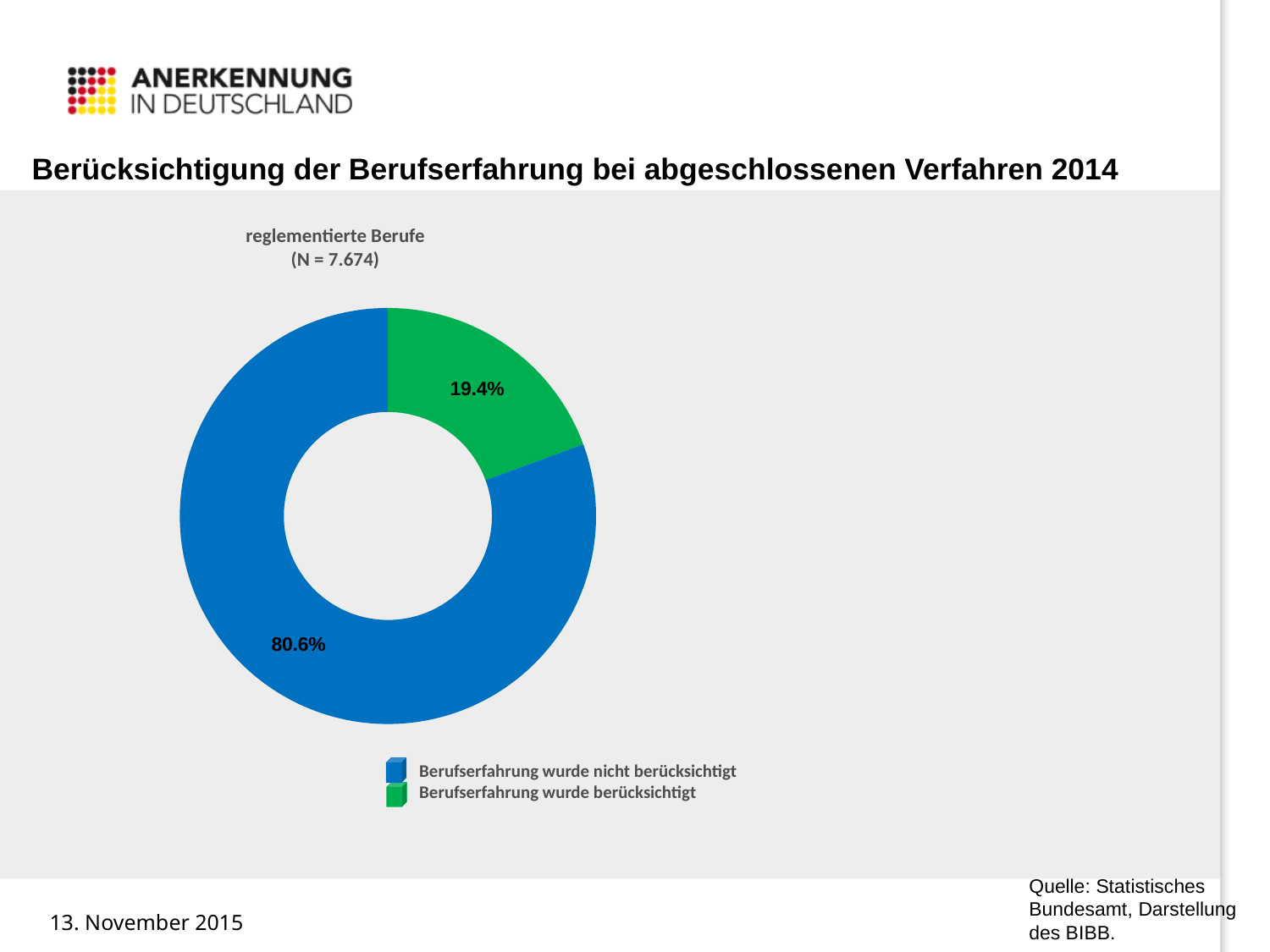
Which slice is larger: 'Berufserfahrung wurde berücksichtigt' or 'Berufserfahrung wurde nicht berücksichtigt'? Berufserfahrung wurde nicht berücksichtigt What is the difference in percentage points between the two slices of the chart? 61.2 Which colour represents 'Berufserfahrung wurde berücksichtigt' in the chart? Green What share of the donut chart is labelled 'Berufserfahrung wurde berücksichtigt'? 19.4% What is the N value given for 'reglementierte Berufe' above the chart? N = 7.674 Which category has the smallest slice in the chart? Berufserfahrung wurde berücksichtigt What share of the donut chart is labelled 'Berufserfahrung wurde nicht berücksichtigt'? 80.6% What kind of chart is shown on the slide? Donut (pie) chart How many slices does the chart have? 2 How many entries does the legend list? 2 Which category has the largest slice in the chart? Berufserfahrung wurde nicht berücksichtigt